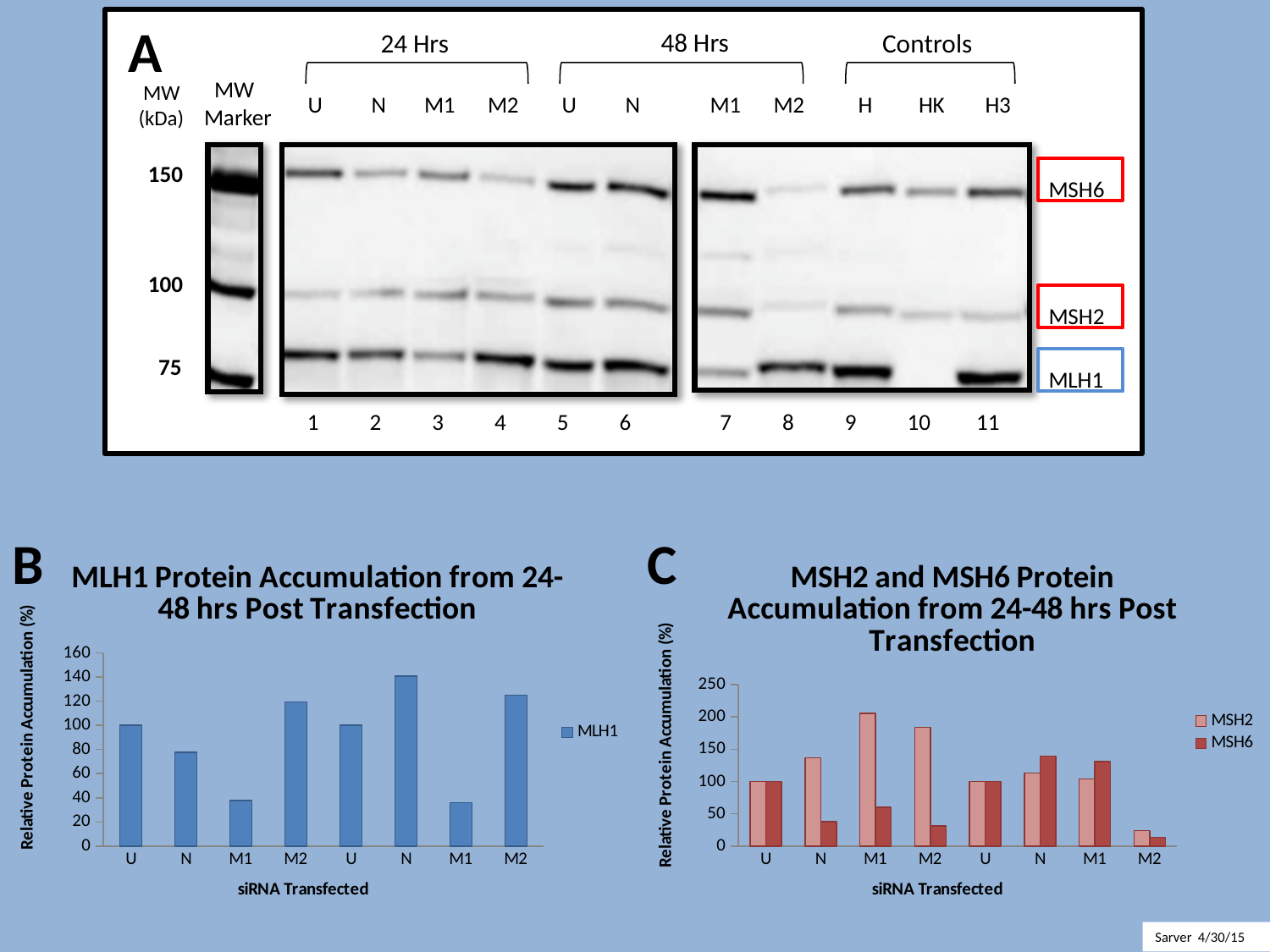
In chart C, "MSH2 and MSH6 Protein Accumulation", is the MSH6 value for the first N category greater or less than 50? less In chart C, "MSH2 and MSH6 Protein Accumulation", which category has the lowest MSH6 bar? the second M2 What kind of chart is chart B, "MLH1 Protein Accumulation from 24-48 hrs Post Transfection"? bar chart In chart C, "MSH2 and MSH6 Protein Accumulation", which category has the highest MSH2 bar? the first M1 In chart C, "MSH2 and MSH6 Protein Accumulation", what is the MSH2 value for the first U category? 100 How many bars are plotted in chart B, "MLH1 Protein Accumulation"? 8 In chart C, "MSH2 and MSH6 Protein Accumulation", for the second N category, which is larger, MSH2 or MSH6? MSH6 In chart B, "MLH1 Protein Accumulation", is the value of the first M2 bar greater or less than 100? greater In chart B, "MLH1 Protein Accumulation", is the value of the first N bar greater or less than 100? less In chart B, "MLH1 Protein Accumulation", what is the value of the first U bar? 100 In chart B, "MLH1 Protein Accumulation", which bar is the highest? the second N bar How many series does the legend of chart C, "MSH2 and MSH6 Protein Accumulation", list? 2